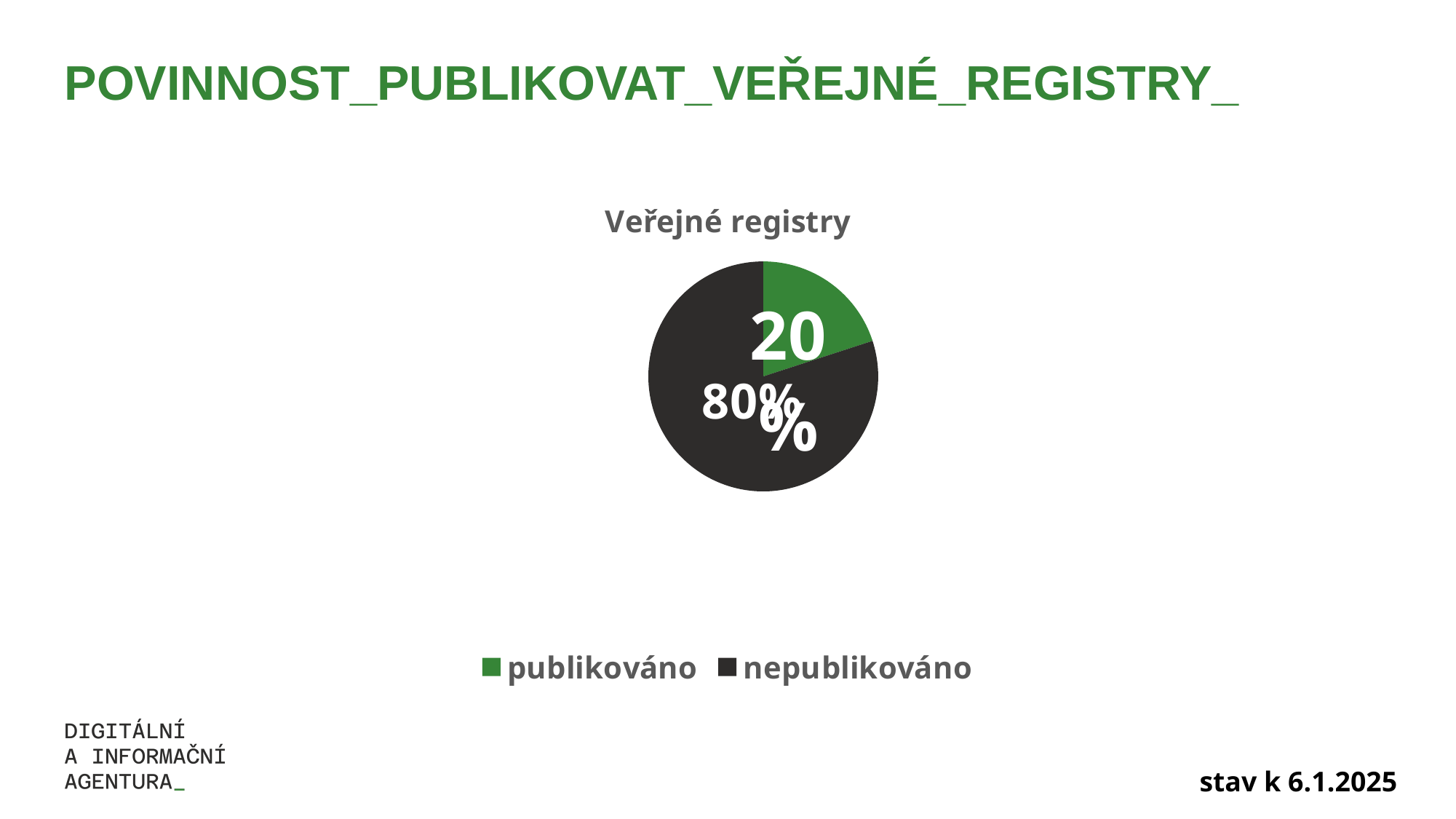
What share of the pie is labelled 'publikováno'? 20% How many categories does the legend list? 2 What colour is the 'publikováno' slice? green What is the difference in percentage points between the 'nepublikováno' and 'publikováno' shares? 60 percentage points Which is larger, the share for 'publikováno' or for 'nepublikováno'? nepublikováno Which category has the smallest slice of the pie? publikováno What is the title of the chart? Veřejné registry Which category has the largest slice of the pie? nepublikováno What kind of chart is shown on the slide? pie chart What share of the pie is labelled 'nepublikováno'? 80%